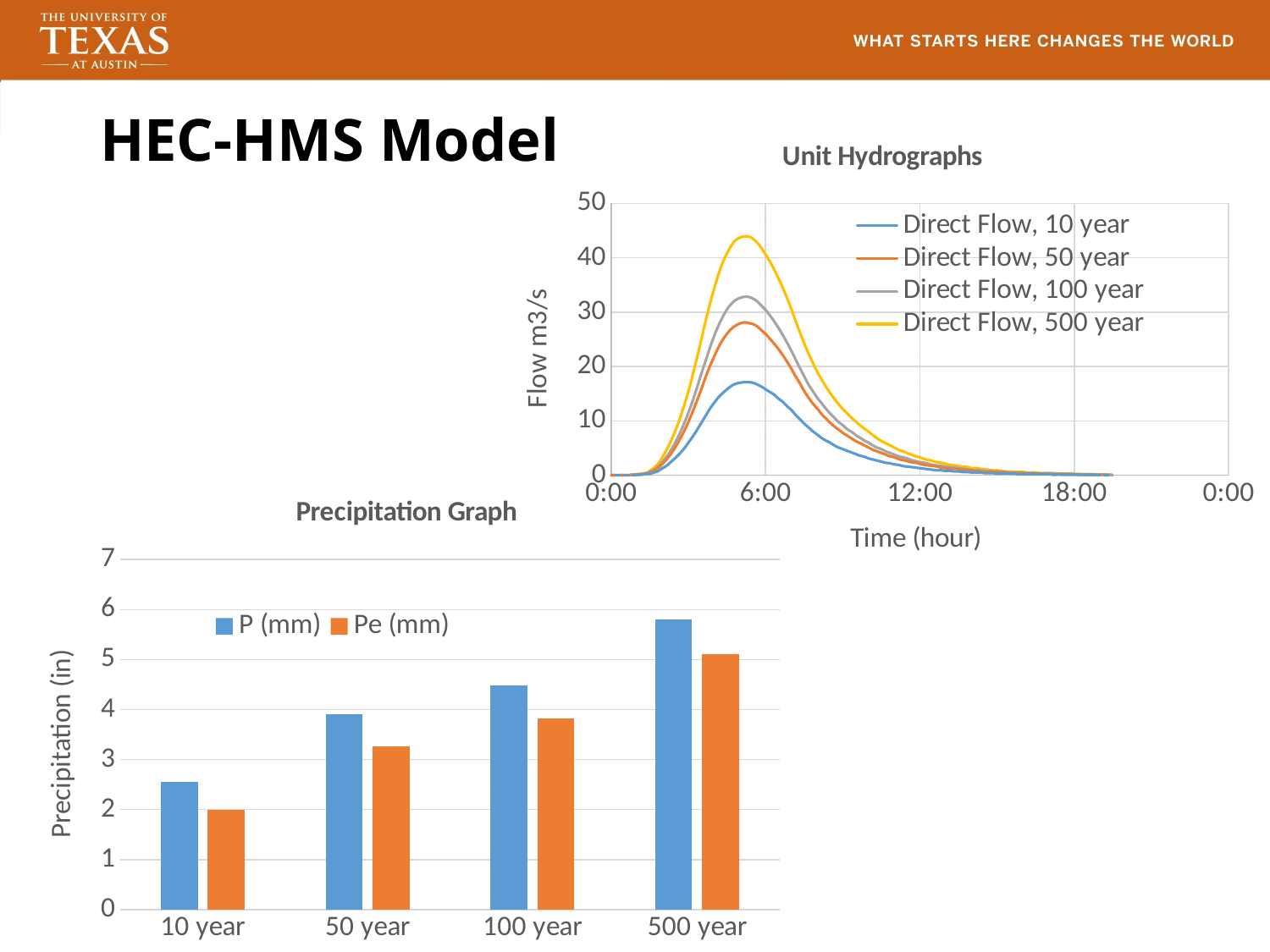
On the Precipitation Graph chart, is the P (mm) value for 10 year greater or less than 3? less On the Precipitation Graph chart, which is larger for 100 year, P (mm) or Pe (mm)? P (mm) On the Precipitation Graph chart, which category has the highest P (mm) value? 500 year On the Unit Hydrographs chart, is the peak flow of Direct Flow, 10 year greater or less than 20? less On the Unit Hydrographs chart, which series reaches the highest peak flow? Direct Flow, 500 year On the Precipitation Graph chart, how many series does the legend list? 2 On the Precipitation Graph chart, what kind of chart is it? bar chart On the Precipitation Graph chart, how many categories are shown on the x axis? 4 On the Unit Hydrographs chart, what kind of chart is it? line chart On the Precipitation Graph chart, which category has the lowest Pe (mm) value? 10 year On the Unit Hydrographs chart, how many series does the legend list? 4 On the Precipitation Graph chart, is the P (mm) value for 500 year greater or less than 5? greater